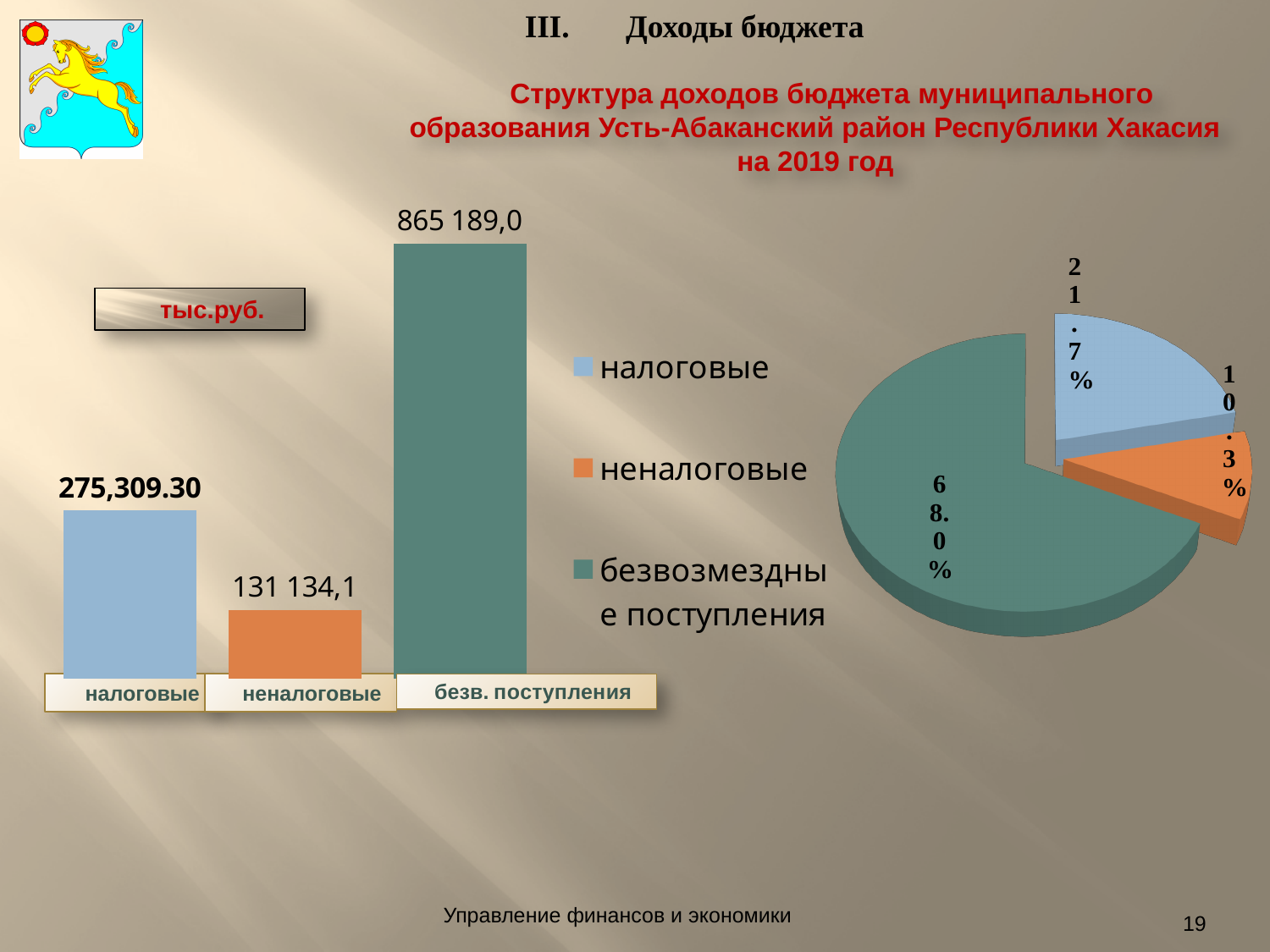
How many bars are in the bar chart on the left? 3 In the bar chart on the left, what is the difference between безв. поступления and неналоговые? 734 054,9 In the pie chart on the right, what share does налоговые have? 21.7% In the bar chart on the left, what is the value for налоговые? 275,309.30 How many entries does the legend between the two charts list? 3 What kind of chart is shown on the left of the slide? bar chart In the bar chart on the left, which category has the highest value? безв. поступления In the bar chart on the left, what is the value for неналоговые? 131 134,1 In the bar chart on the left, which category has the lowest value? неналоговые In the bar chart on the left, which is larger: налоговые or неналоговые? налоговые In the bar chart on the left, what is the value for безв. поступления? 865 189,0 In the pie chart on the right, what share does безвозмездные поступления have? 68.0%